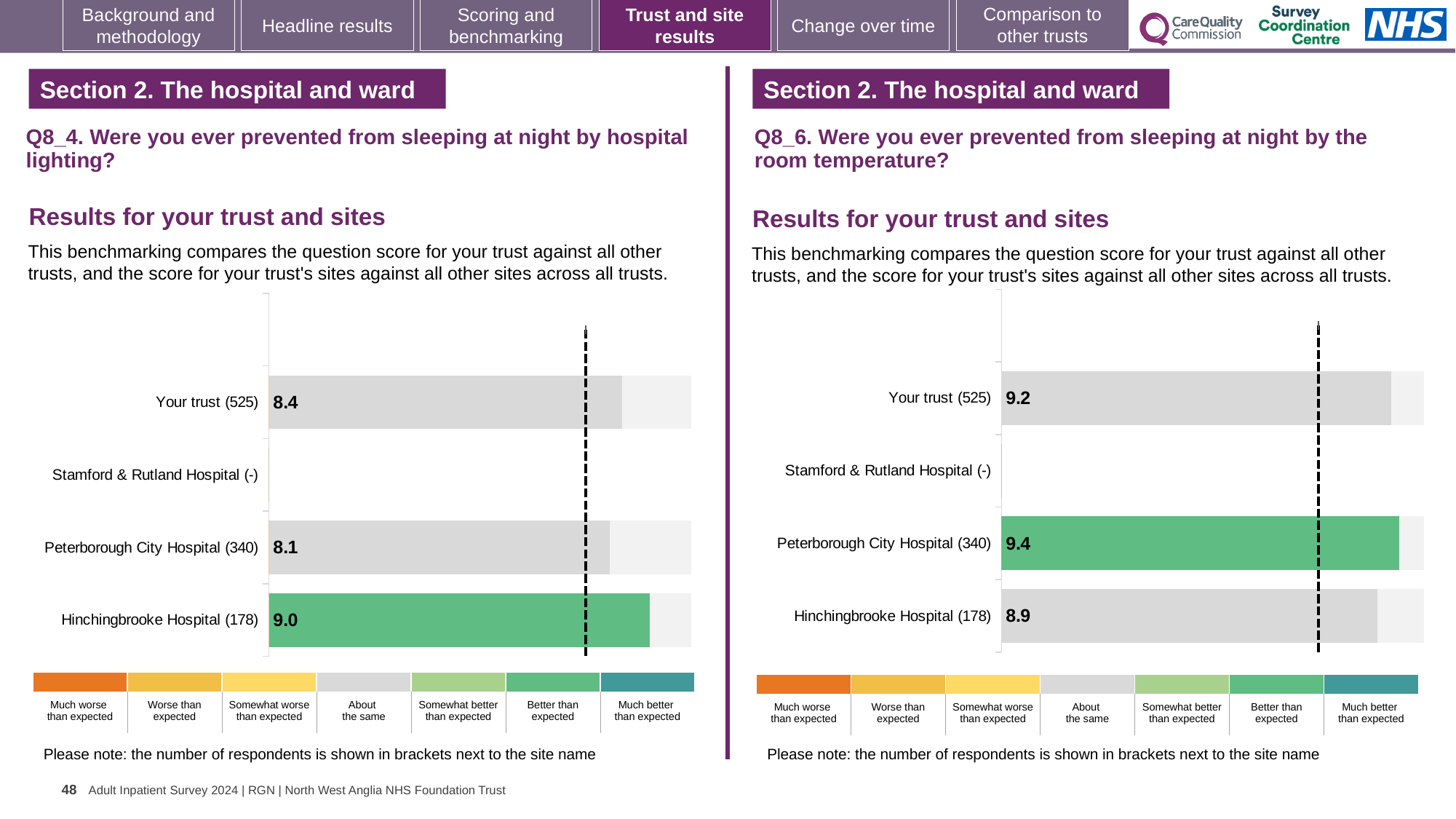
In the Q8_4 chart (hospital lighting), which site has the lowest score shown? Peterborough City Hospital (340) In the Q8_6 chart (room temperature), what is the score for Your trust (525)? 9.2 In the Q8_6 chart (room temperature), which site has the highest score? Peterborough City Hospital (340) What kind of chart is used in the Q8_4 chart (hospital lighting)? Bar chart How many site rows (including Your trust) are listed in the Q8_6 chart (room temperature)? 4 In the Q8_6 chart (room temperature), is the score for Hinchingbrooke Hospital or Your trust larger? Your trust In the Q8_4 chart (hospital lighting), what is the difference between the scores for Hinchingbrooke Hospital and Peterborough City Hospital? 0.9 In the Q8_6 chart (room temperature), what is the difference between the scores for Peterborough City Hospital and Hinchingbrooke Hospital? 0.5 In the Q8_4 chart (hospital lighting), which bar is coloured green? Hinchingbrooke Hospital (178) In the Q8_6 chart (room temperature), what is the score for Peterborough City Hospital (340)? 9.4 In the Q8_4 chart (hospital lighting), what is the score for Your trust (525)? 8.4 In the Q8_4 chart (hospital lighting), what is the score for Hinchingbrooke Hospital (178)? 9.0